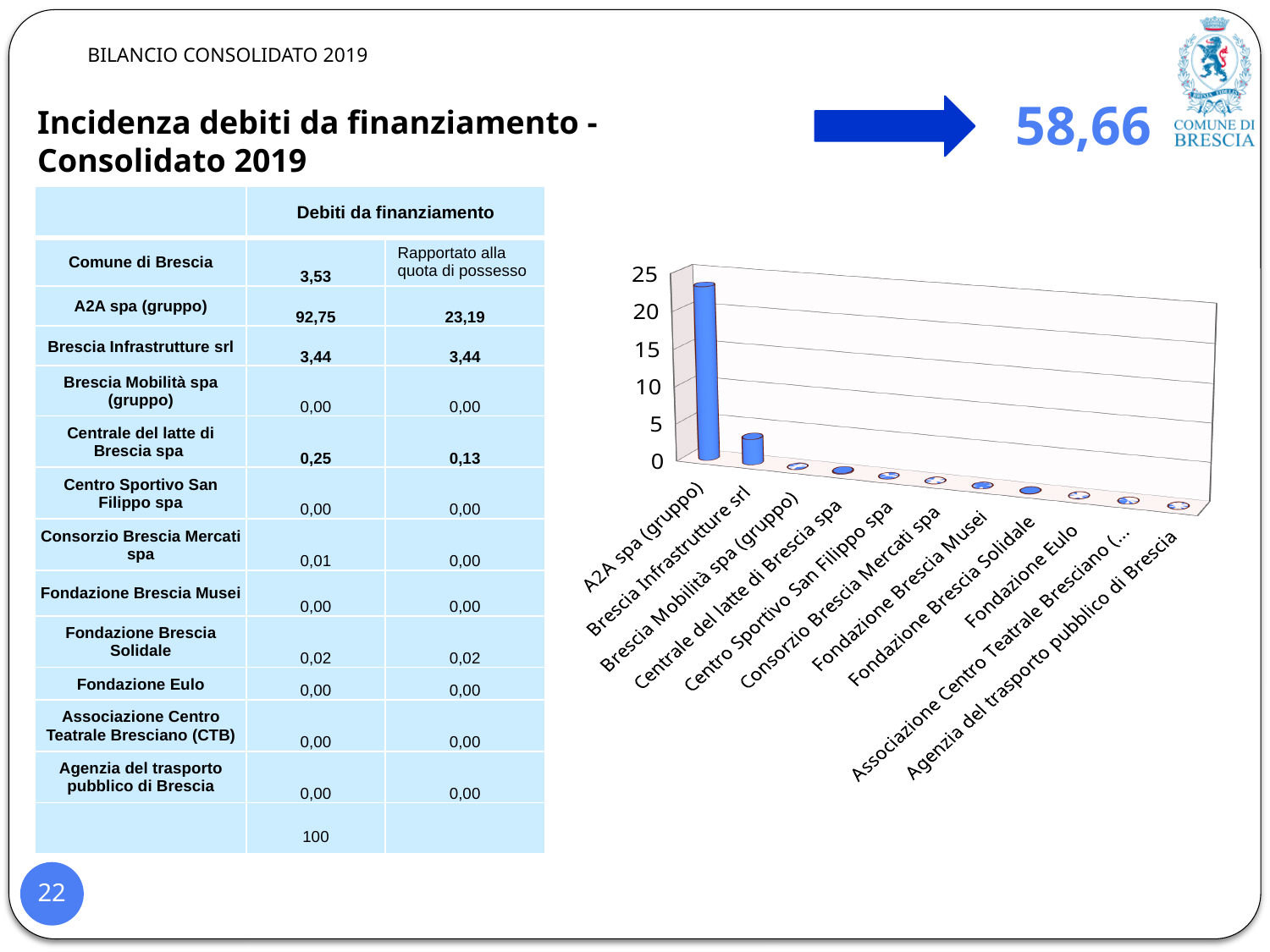
What is the highest tick value shown on the chart's vertical axis? 25 How many categories are plotted on the chart's x axis? 11 Do the bar values generally rise or fall moving left to right along the x axis? fall Which is larger, the bar for Brescia Infrastrutture srl or the bar for Fondazione Brescia Musei? Brescia Infrastrutture srl Is the value for Brescia Infrastrutture srl greater or less than 5? less Is the value for A2A spa (gruppo) greater or less than 20? greater Which is larger, the bar for A2A spa (gruppo) or the bar for Brescia Infrastrutture srl? A2A spa (gruppo) Is the value for Fondazione Eulo greater or less than 5? less What is the label of the first category on the chart's x axis? A2A spa (gruppo) Which category has the highest bar in the chart? A2A spa (gruppo) What kind of chart is shown on the slide? bar chart